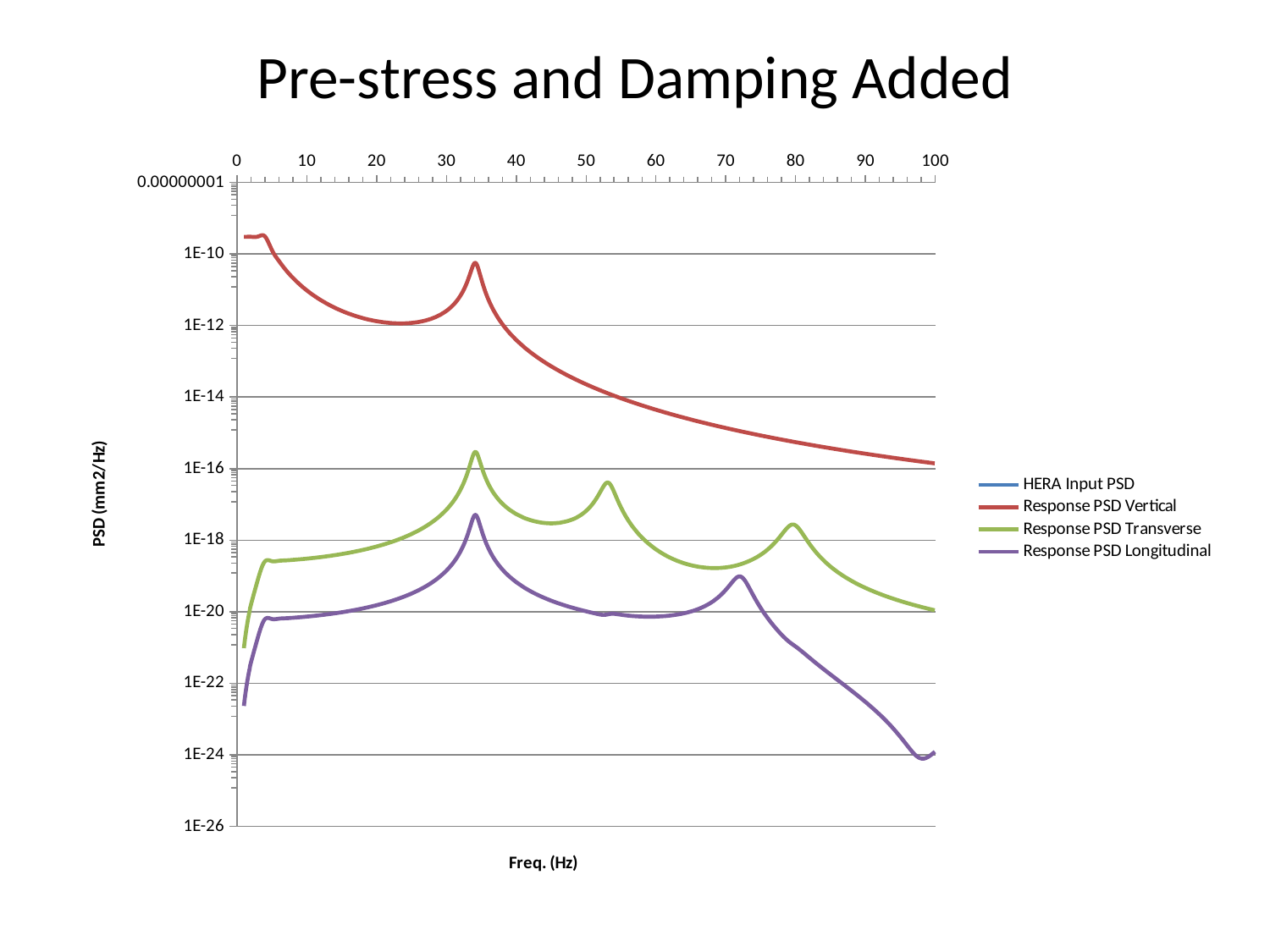
Which series has the lowest PSD value at 100 Hz? Response PSD Longitudinal Is the Response PSD Longitudinal value at 100 Hz greater or less than 1E-22? less Which series has the highest PSD values across the frequency range? Response PSD Vertical Does the Response PSD Vertical curve rise or fall between 40 Hz and 100 Hz? fall How many series does the legend list? 4 What is the title of the chart? Pre-stress and Damping Added Is the Response PSD Transverse value at 100 Hz greater or less than 1E-18? less Is the Response PSD Vertical value at 10 Hz greater or less than 1E-12? greater How many peaks does the Response PSD Transverse curve show between 0 and 100 Hz? 3 What kind of chart is shown on the slide? line chart At 50 Hz, which is larger: Response PSD Transverse or Response PSD Longitudinal? Response PSD Transverse What is the label of the x axis? Freq. (Hz)